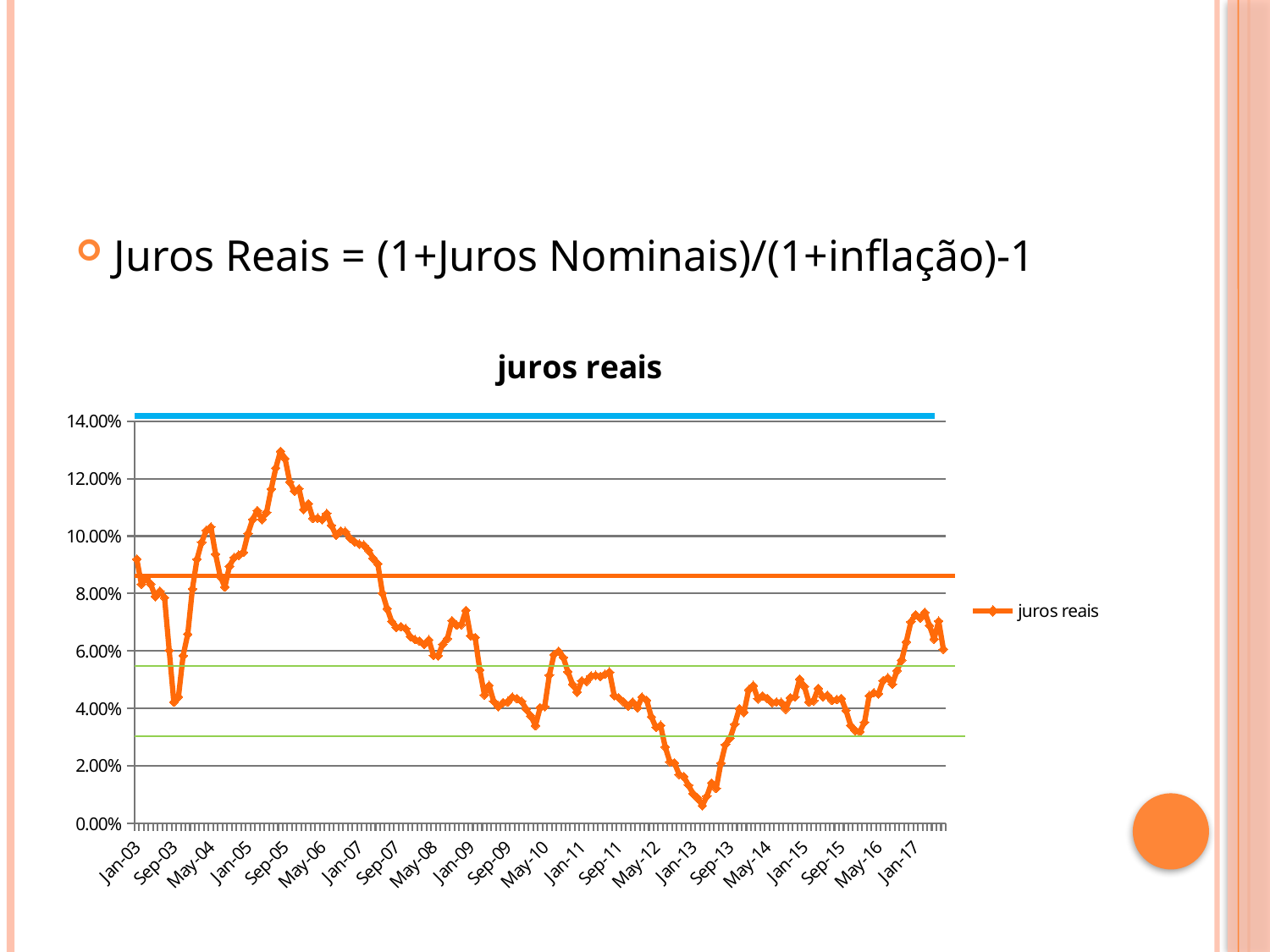
Around which x-axis label does the juros reais line reach its lowest value? Jan-13 What is the title of the chart? juros reais What is the name of the series shown in the legend? juros reais Around which x-axis label does the juros reais line reach its highest value? Sep-05 What kind of chart is shown on the slide? line chart How many series does the chart legend list? 1 Does the juros reais line overall rise or fall between Sep-05 and Jan-13? fall Is the value for Jan-03 greater or less than 8.00%? greater Is the value for Sep-05 greater or less than 12.00%? greater Is the value for Jan-13 greater or less than 2.00%? less Which is larger, the value at Sep-05 or the value at Jan-13? Sep-05